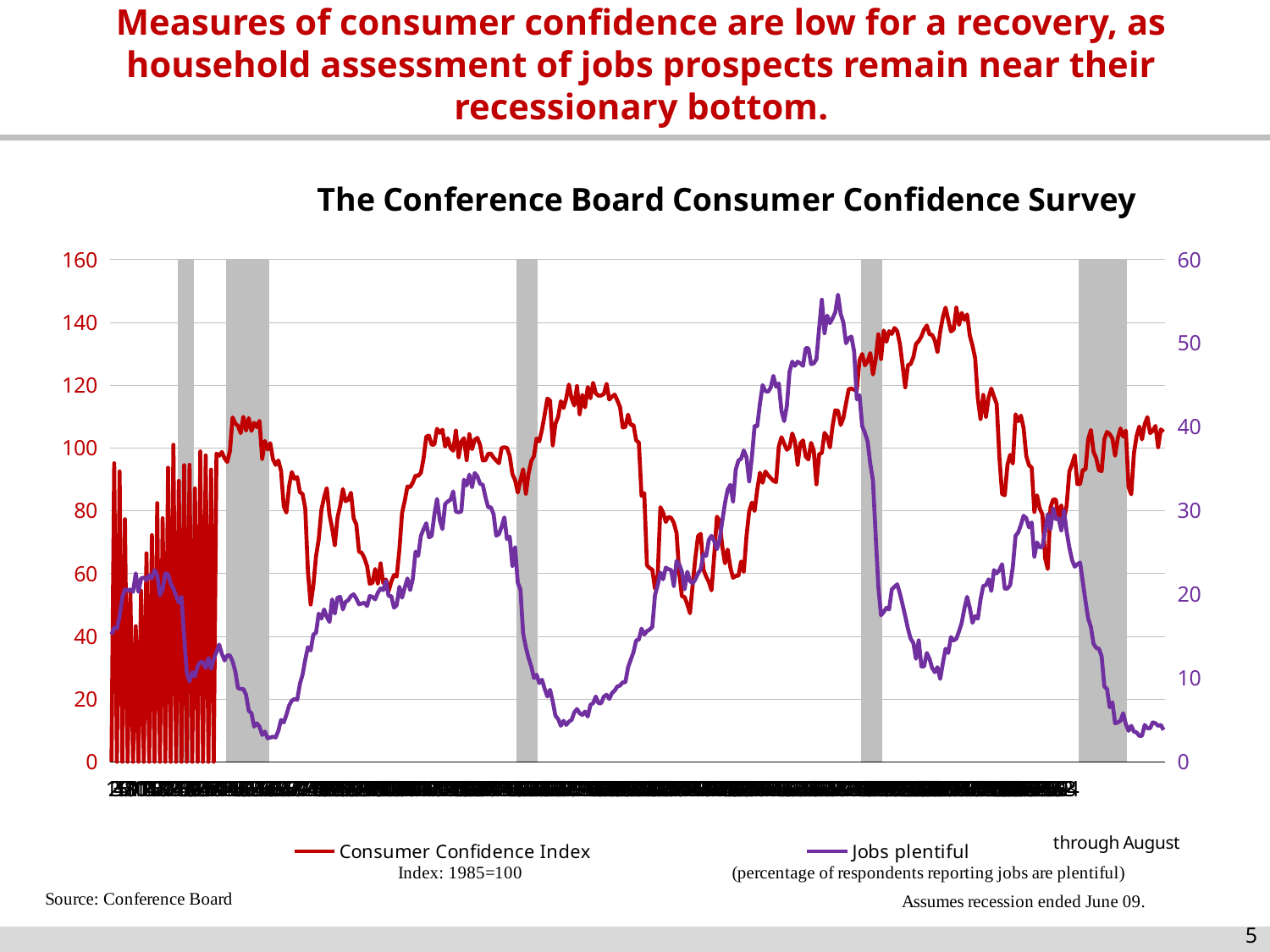
What is the highest value shown on the left vertical axis? 160 Through which month does the chart's data run, according to the note at the bottom right? August What is the source cited for the chart? Conference Board Is the final value of the Consumer Confidence Index, at the right end of the chart, greater or less than 80 on the left axis? greater What kind of chart is shown on the slide? combination bar and line chart What is the title of the chart? The Conference Board Consumer Confidence Survey According to the note under the legend, what base year is the Consumer Confidence Index set to 100? 1985 How many series does the legend list? 2 Which series is drawn in purple? Jobs plentiful What is the highest value shown on the right vertical axis? 60 Is the final value of the Jobs plentiful series, at the right end of the chart, greater or less than 10 on the right axis? less Is the final value of the Consumer Confidence Index, at the right end of the chart, greater or less than 120 on the left axis? less